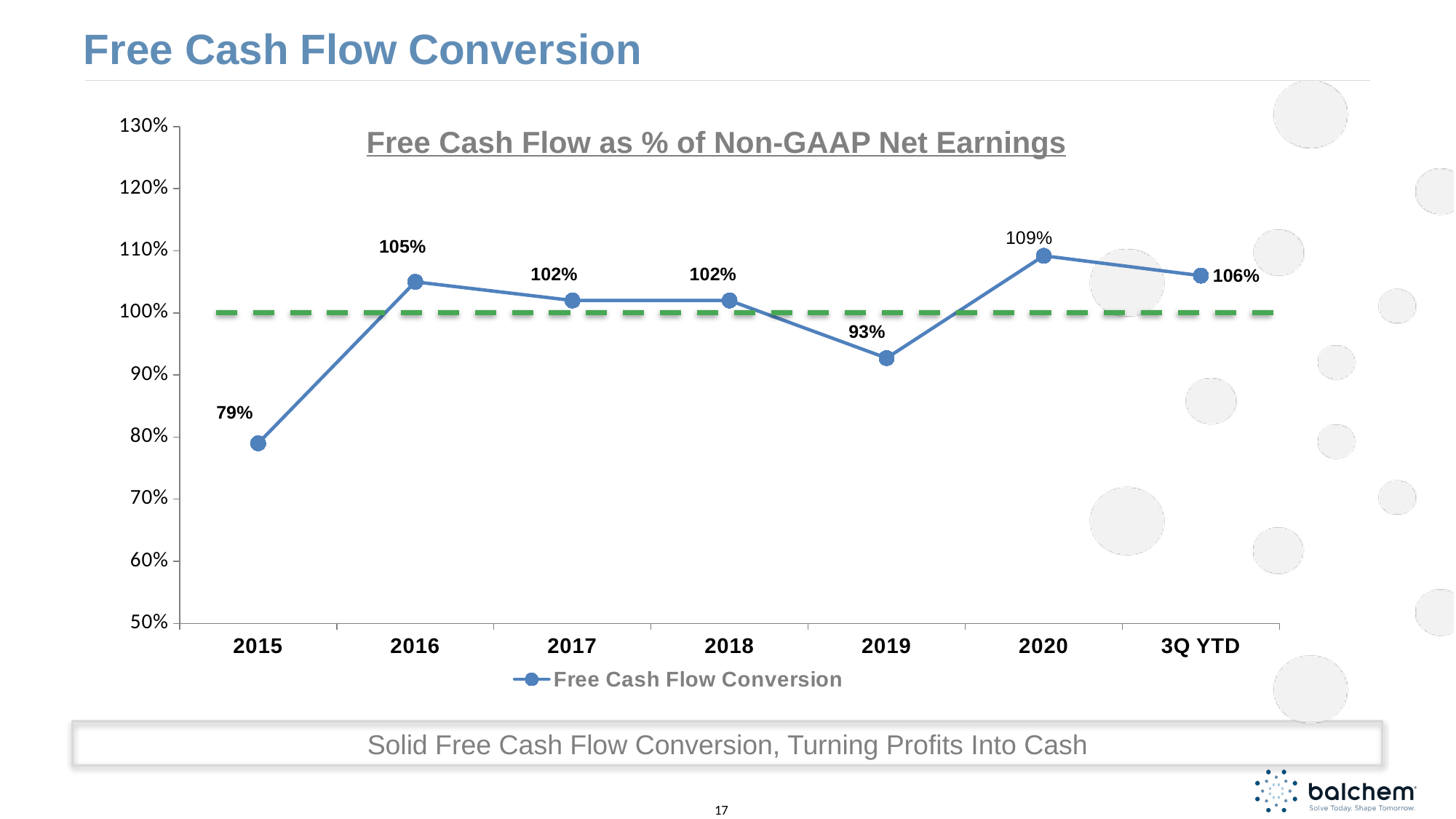
What is the title of the chart? Free Cash Flow as % of Non-GAAP Net Earnings How many series does the legend list? 1 Which year has the highest Free Cash Flow Conversion? 2020 Which year has the lowest Free Cash Flow Conversion? 2015 How many data points are plotted on the chart? 7 Which is larger, the Free Cash Flow Conversion in 2020 or in 2019? 2020 What is the Free Cash Flow Conversion value for 3Q YTD? 106% What is the difference between the Free Cash Flow Conversion in 2016 and in 2015? 26% Is the Free Cash Flow Conversion for 2019 greater or less than 100%? less What kind of chart is shown on the slide? line chart What is the Free Cash Flow Conversion value for 2019? 93% What is the Free Cash Flow Conversion value for 2015? 79%